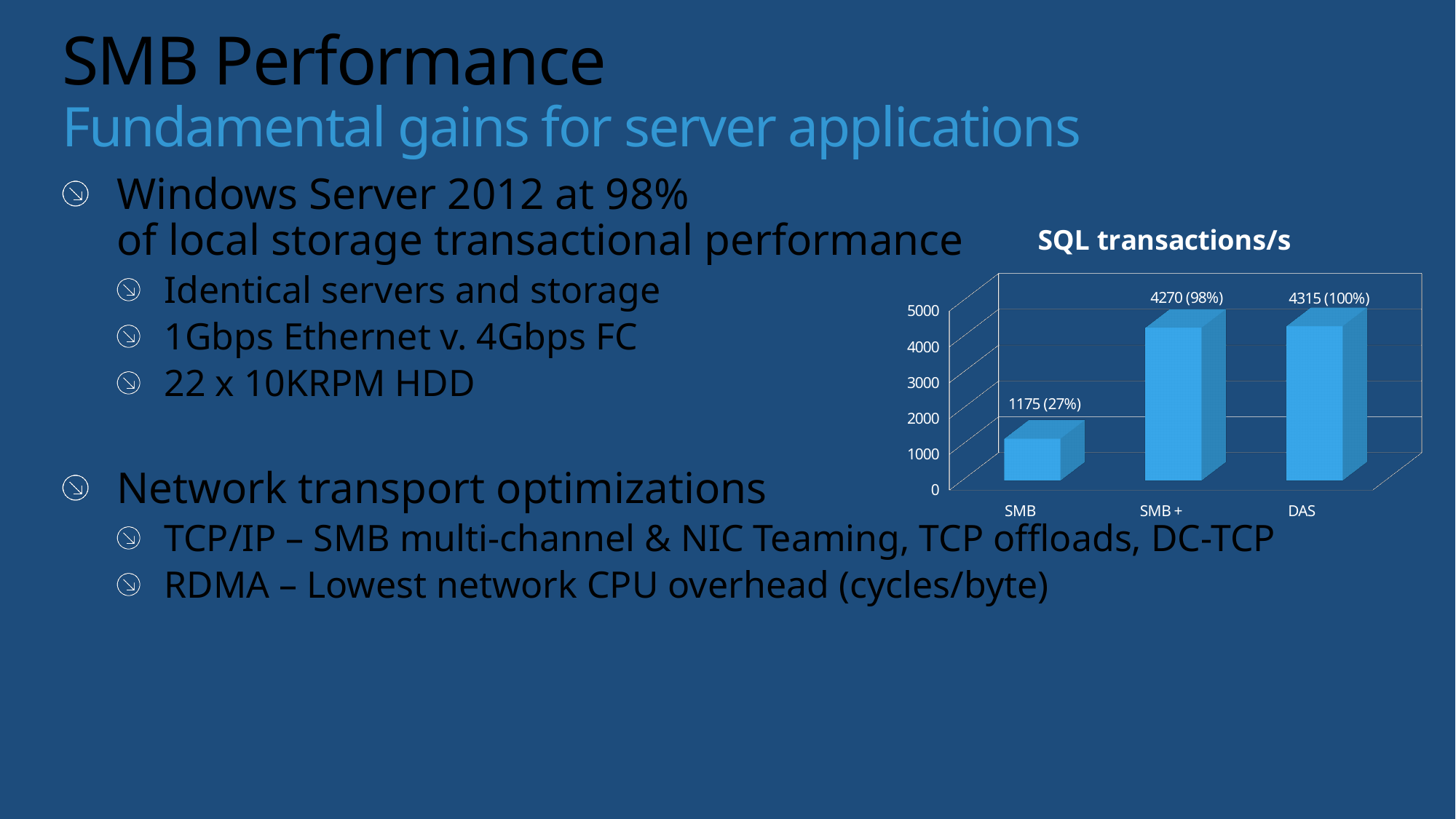
What is the title of the chart on the slide? SQL transactions/s What is the value shown for SMB in the SQL transactions/s chart? 1175 (27%) What is the value shown for SMB + in the SQL transactions/s chart? 4270 (98%) Which category has the highest value in the SQL transactions/s chart? DAS Which category has the lowest value in the SQL transactions/s chart? SMB What kind of chart is the SQL transactions/s chart? bar chart What is the difference in SQL transactions/s between DAS and SMB? 3140 How many categories are shown in the SQL transactions/s chart? 3 Is the value for SMB in the SQL transactions/s chart greater or less than 2000? less What is the difference in SQL transactions/s between SMB + and SMB? 3095 Which is larger in the SQL transactions/s chart, SMB or SMB +? SMB + What is the value shown for DAS in the SQL transactions/s chart? 4315 (100%)